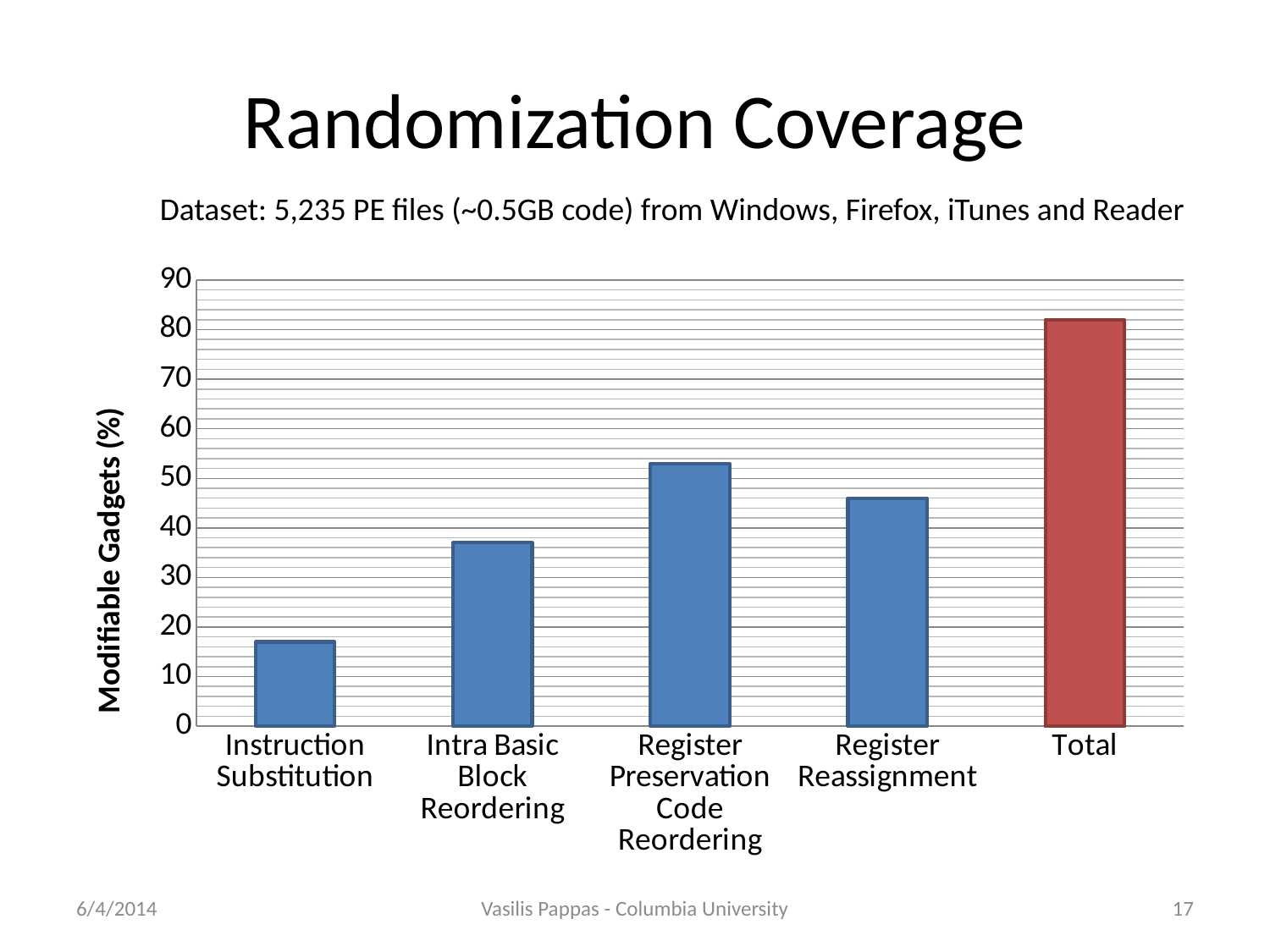
What type of chart is shown on the slide? bar chart Which category has the highest value? Total Which category has the lowest value? Instruction Substitution Is the value for Register Reassignment greater or less than 50? less How many categories are plotted on the x axis? 5 What is the label of the y axis? Modifiable Gadgets (%) Is the value for Register Preservation Code Reordering greater or less than 60? less Which bar is coloured red rather than blue? Total Is the value for Total greater or less than 70? greater Which is larger, the value for Register Preservation Code Reordering or the value for Register Reassignment? Register Preservation Code Reordering